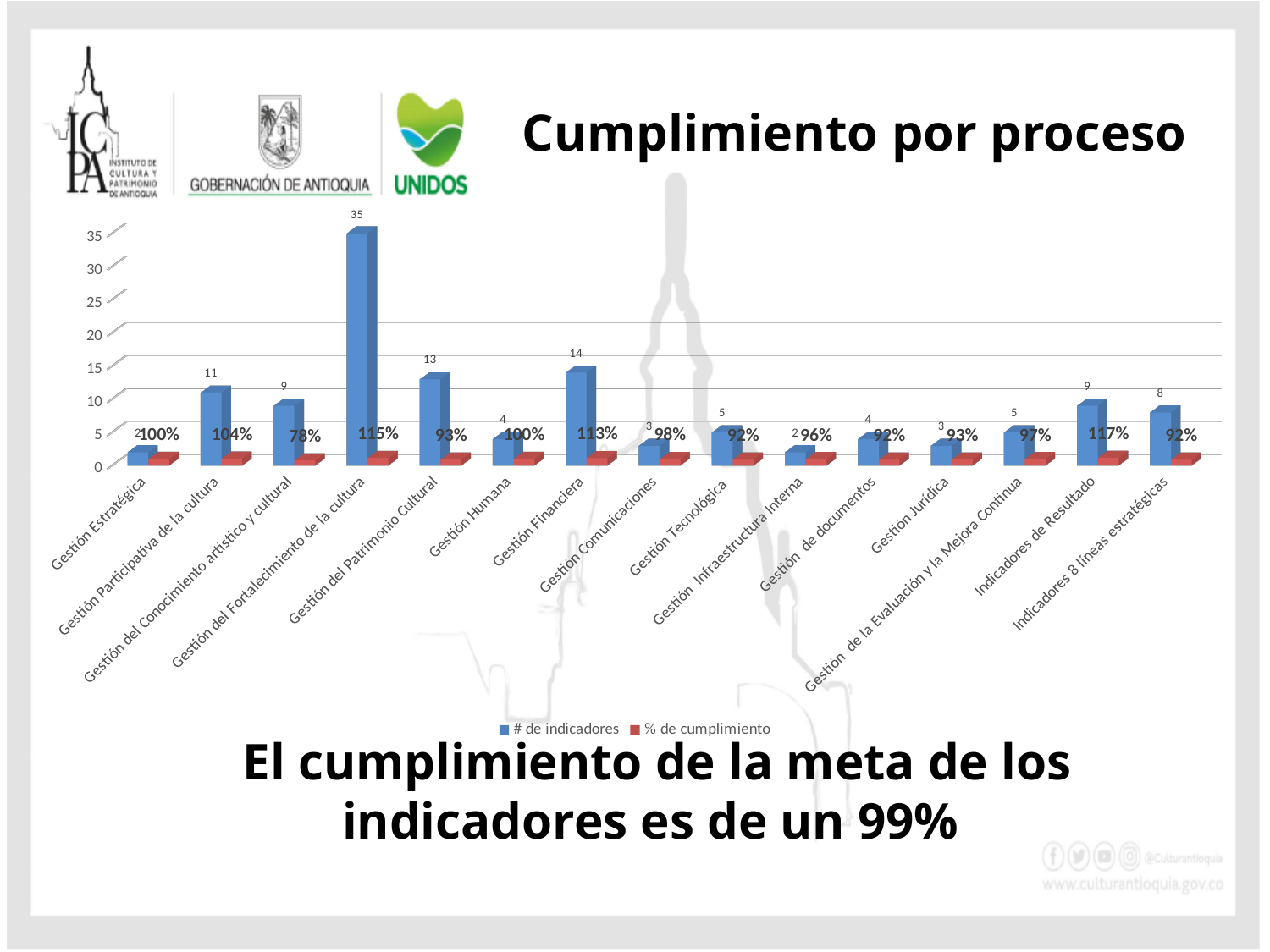
What is the title of the chart on the slide? Cumplimiento por proceso What type of chart is shown on the slide? Bar chart What is the % de cumplimiento for Indicadores de Resultado? 117% How many series does the legend list? 2 How many categories are shown on the x axis? 15 What is the % de cumplimiento for Gestión del Conocimiento artístico y cultural? 78% What is the number of indicators (# de indicadores) for Gestión del Fortalecimiento de la cultura? 35 Which category has the lowest % de cumplimiento? Gestión del Conocimiento artístico y cultural What is the number of indicators (# de indicadores) for Gestión Financiera? 14 What is the difference in number of indicators between Gestión del Fortalecimiento de la cultura and Gestión del Patrimonio Cultural? 22 Which category has the highest number of indicators (# de indicadores)? Gestión del Fortalecimiento de la cultura Which has more indicators (# de indicadores): Gestión Participativa de la cultura or Gestión Humana? Gestión Participativa de la cultura